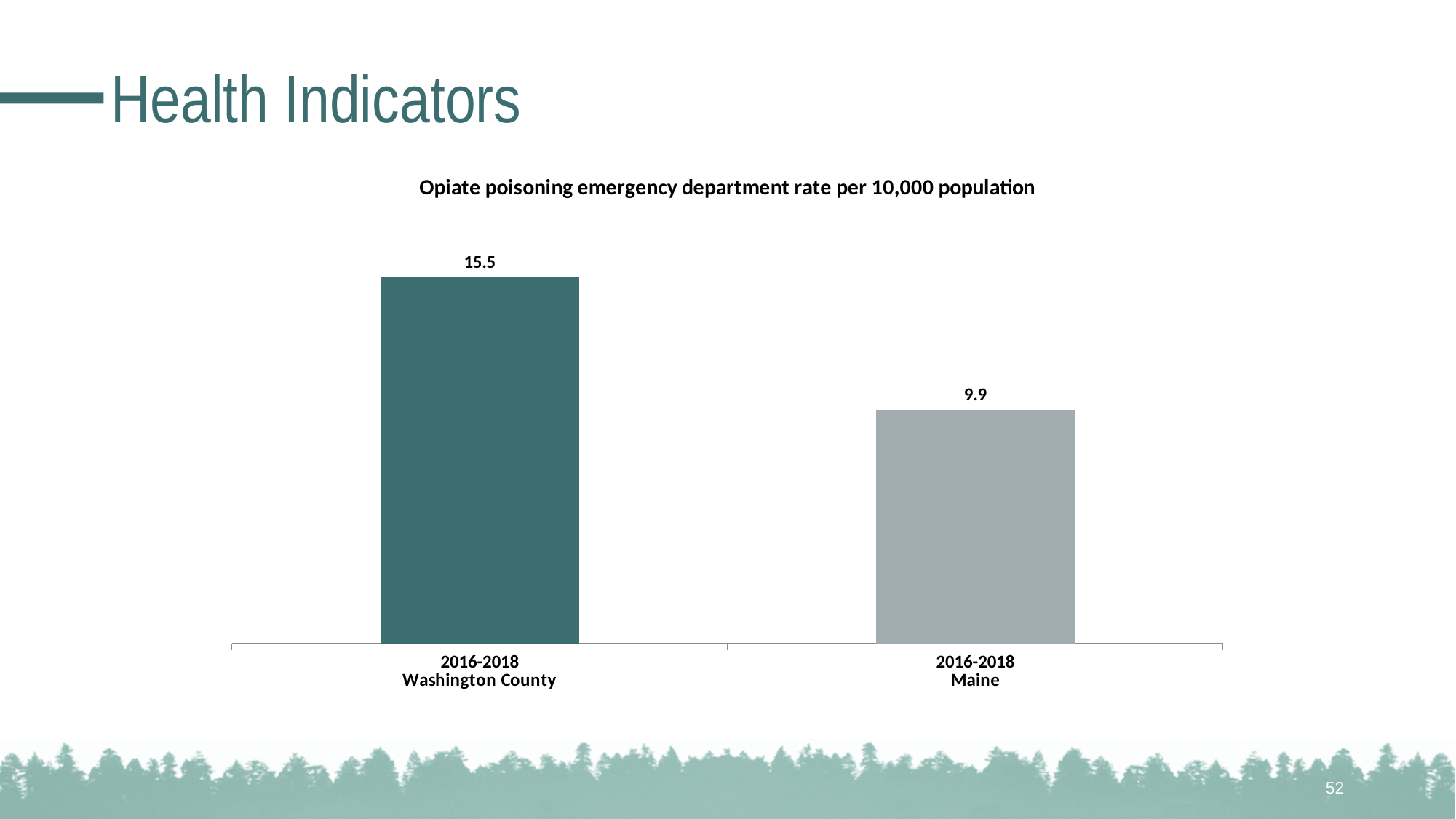
Is the rate for Washington County larger or smaller than the rate for Maine? larger Which category has the higher opiate poisoning emergency department rate? 2016-2018 Washington County What kind of chart is shown on the slide? bar chart What is the opiate poisoning emergency department rate per 10,000 population for Maine in 2016-2018? 9.9 What is the opiate poisoning emergency department rate per 10,000 population for Washington County in 2016-2018? 15.5 How many bars are shown in the chart? 2 Which category has the lower opiate poisoning emergency department rate? 2016-2018 Maine What time period do both bars in the chart cover? 2016-2018 What is the title of the chart? Opiate poisoning emergency department rate per 10,000 population What is the difference between the Washington County rate and the Maine rate? 5.6